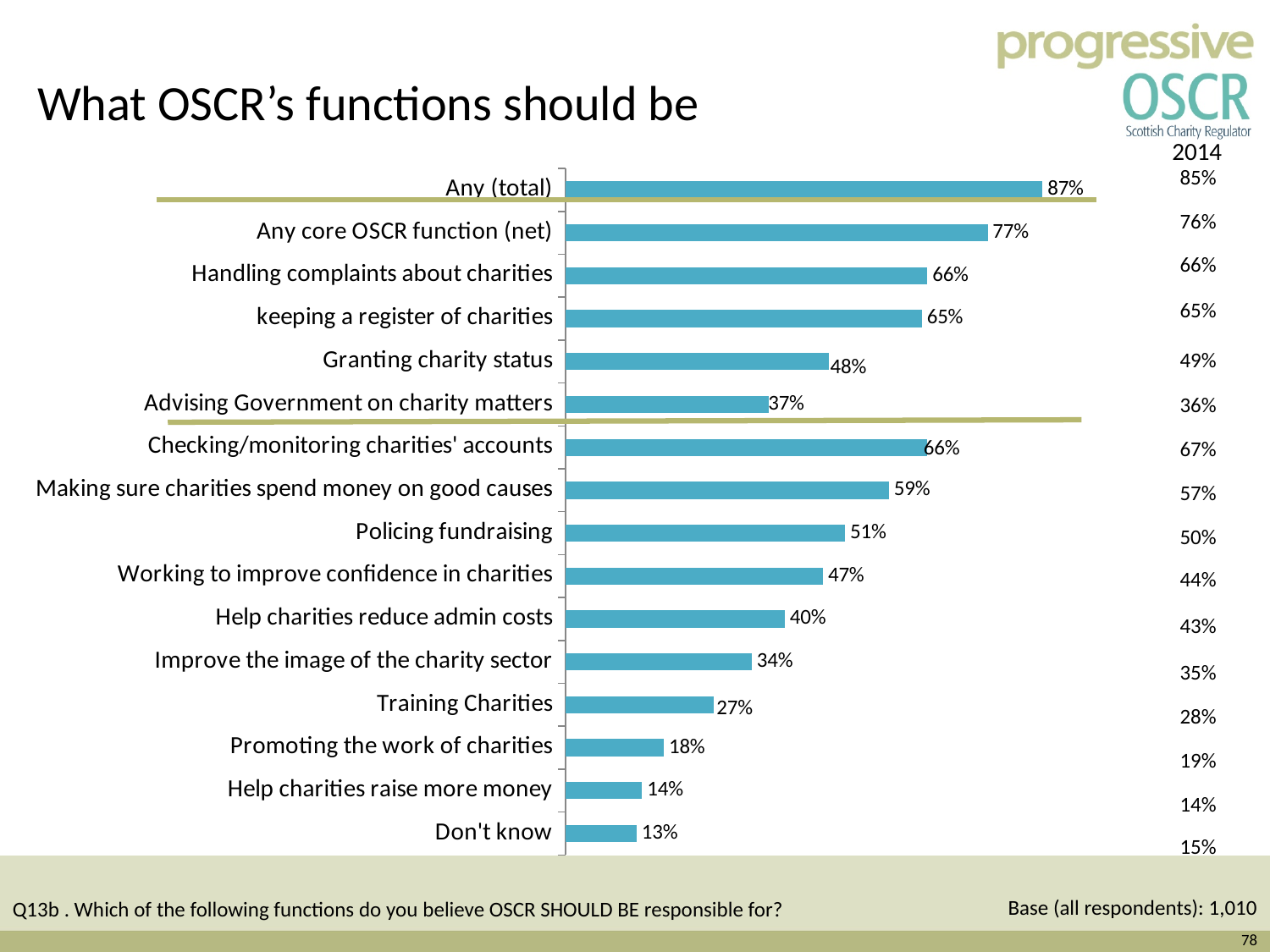
What percentage is shown for 'Handling complaints about charities'? 66% What is the value for 'Help charities reduce admin costs'? 40% What type of chart is shown on the slide? Bar chart What is the difference between 'Policing fundraising' and 'Training Charities'? 24 percentage points What percentage of respondents said 'Don't know'? 13% How many categories are plotted in the chart? 16 Which is larger: 'Making sure charities spend money on good causes' or 'Improve the image of the charity sector'? Making sure charities spend money on good causes What is the difference between 'Any (total)' and 'Any core OSCR function (net)'? 10 percentage points Which category has the lowest value in the chart? Don't know What is the value for 'Advising Government on charity matters'? 37% What is the title of the slide containing the chart? What OSCR's functions should be Which category has the highest value in the chart? Any (total)